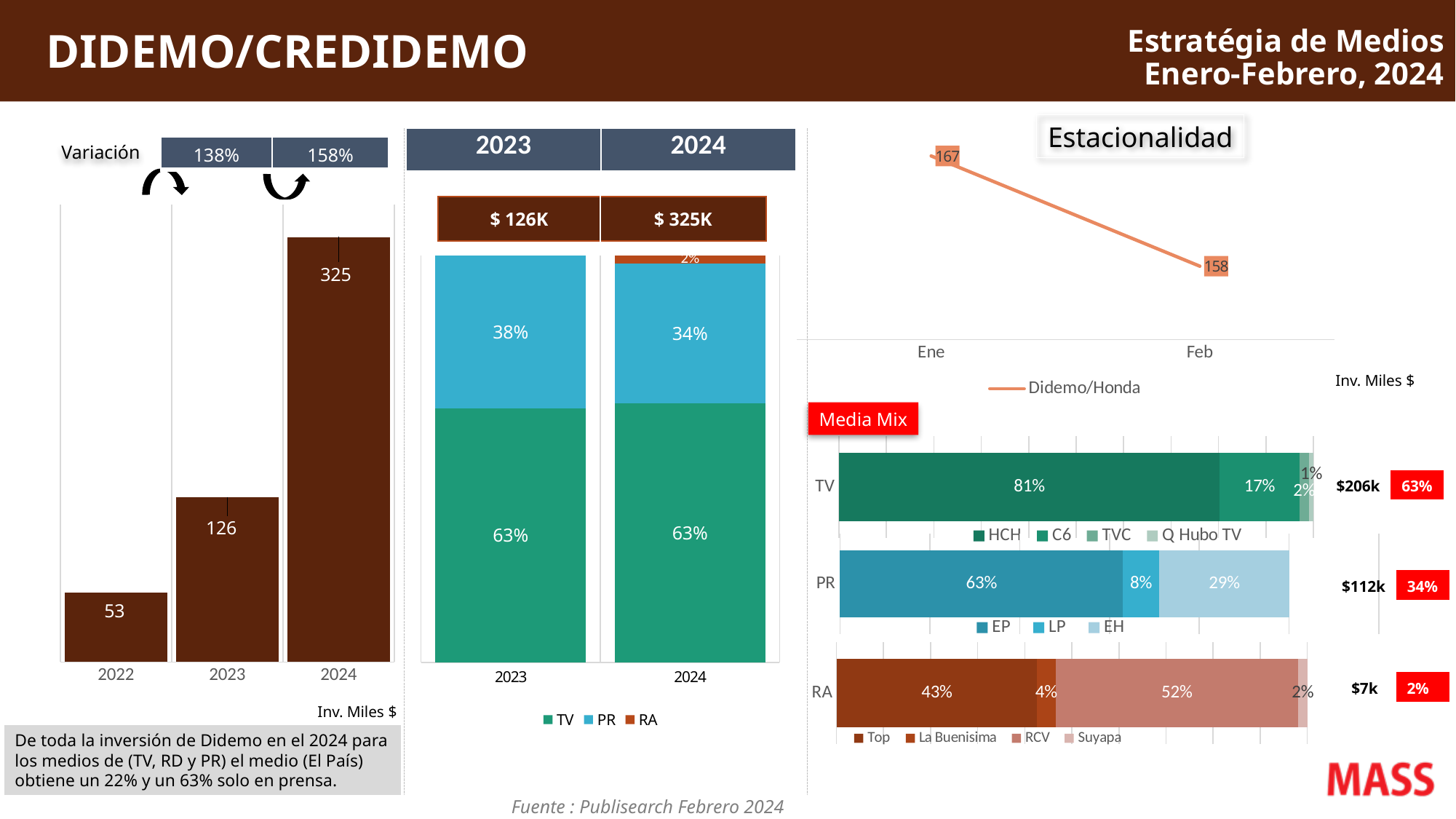
In the Media Mix chart, what share does HCH have in the TV bar? 81% In the middle stacked bar chart (2023 vs 2024), what share does PR have in 2024? 34% In the middle stacked bar chart (2023 vs 2024), which is larger in 2023, TV or PR? TV In the left bar chart of investment by year, do the values rise or fall from 2022 to 2024? rise In the Estacionalidad line chart, what is the difference between the Ene and Feb values? 9 In the left bar chart of investment by year, what is the value for 2024? 325 In the left bar chart of investment by year, which year has the lowest value? 2022 In the left bar chart of investment by year, how many years are shown? 3 In the Media Mix chart, which station has the largest share in the RA bar? RCV In the middle stacked bar chart (2023 vs 2024), how many series does the legend list? 3 In the left bar chart of investment by year, what is the difference between the 2024 and 2023 values? 199 In the Estacionalidad line chart, what is the value for Feb? 158